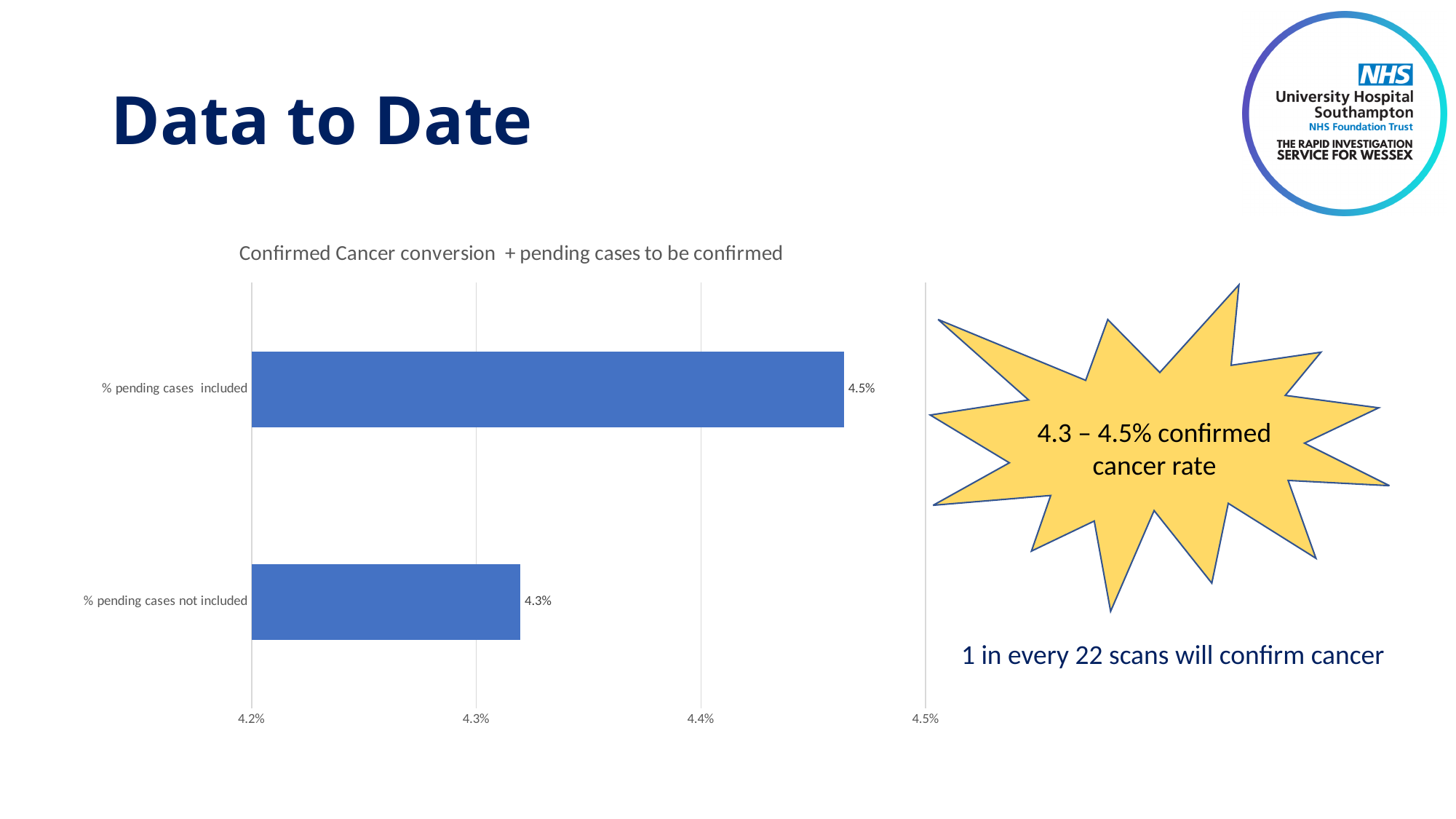
What is the difference between the values for "% pending cases included" and "% pending cases not included"? 0.2% Which category has the lowest value? % pending cases not included What kind of chart is shown on the slide? Bar chart What is the value for "% pending cases included"? 4.5% Which is larger: the value for "% pending cases included" or "% pending cases not included"? % pending cases included Which category has the highest value? % pending cases included Is the value for "% pending cases included" greater or less than 4.4%? greater What is the lowest value shown on the chart's horizontal axis? 4.2% What is the title of the chart? Confirmed Cancer conversion + pending cases to be confirmed Is the value for "% pending cases not included" greater or less than 4.4%? less How many categories are shown in the chart? 2 What is the value for "% pending cases not included"? 4.3%